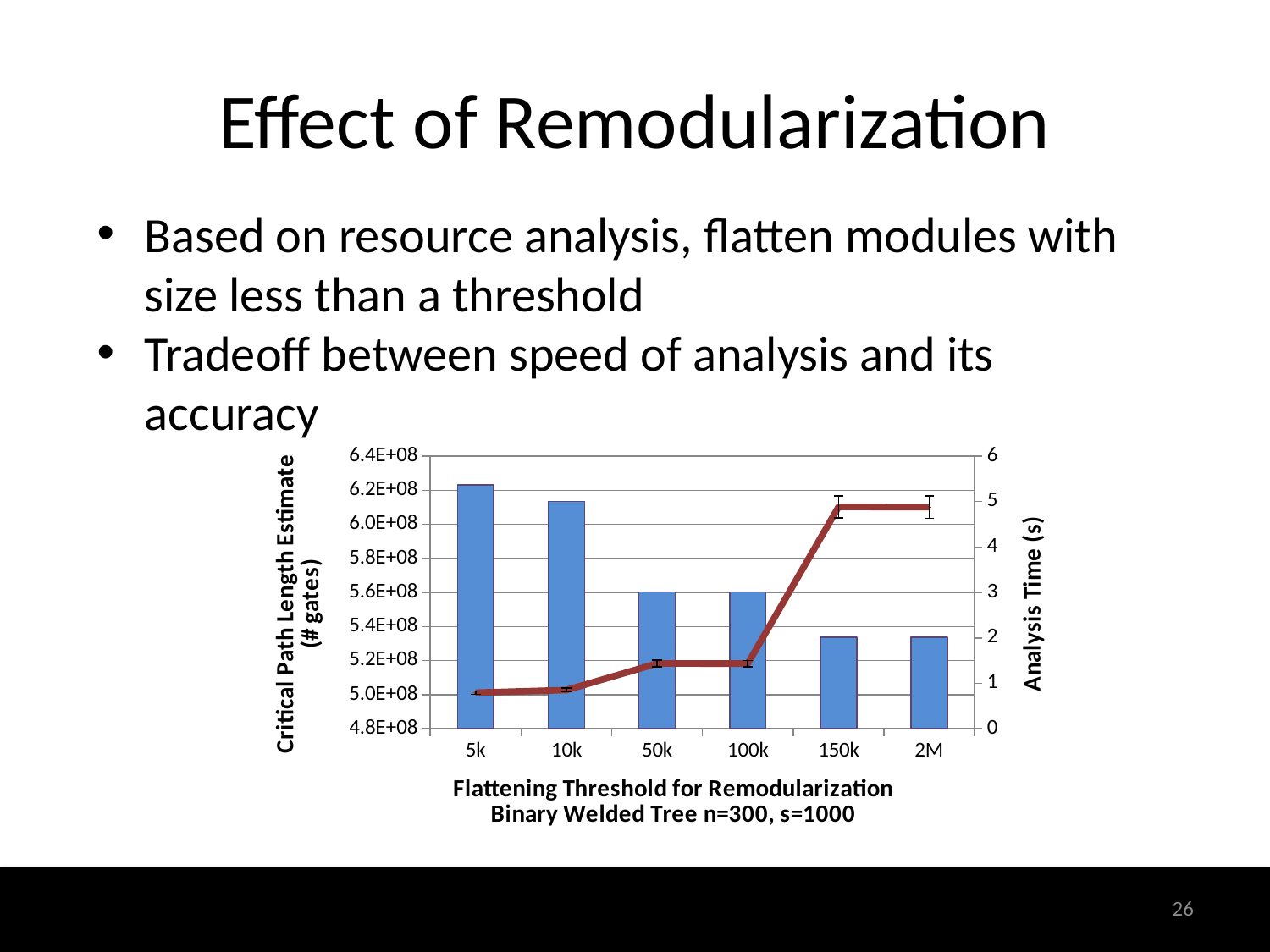
What kind of chart is shown on the slide? A combined bar and line chart Is the Analysis Time for 150k greater or less than 4 seconds? greater Does the Analysis Time line generally rise or fall as the flattening threshold increases? rise Which flattening threshold has the highest Critical Path Length Estimate bar? 5k Is the Critical Path Length Estimate bar for 150k greater or less than 5.4E+08? less How many flattening threshold categories are shown on the x axis? 6 What is the title of the right-hand vertical axis? Analysis Time (s) Which has the larger Critical Path Length Estimate bar, 5k or 10k? 5k Which has the higher Analysis Time, 100k or 150k? 150k Is the Analysis Time for 5k greater or less than 1 second? less Do the Critical Path Length Estimate bars generally rise or fall as the flattening threshold increases? fall